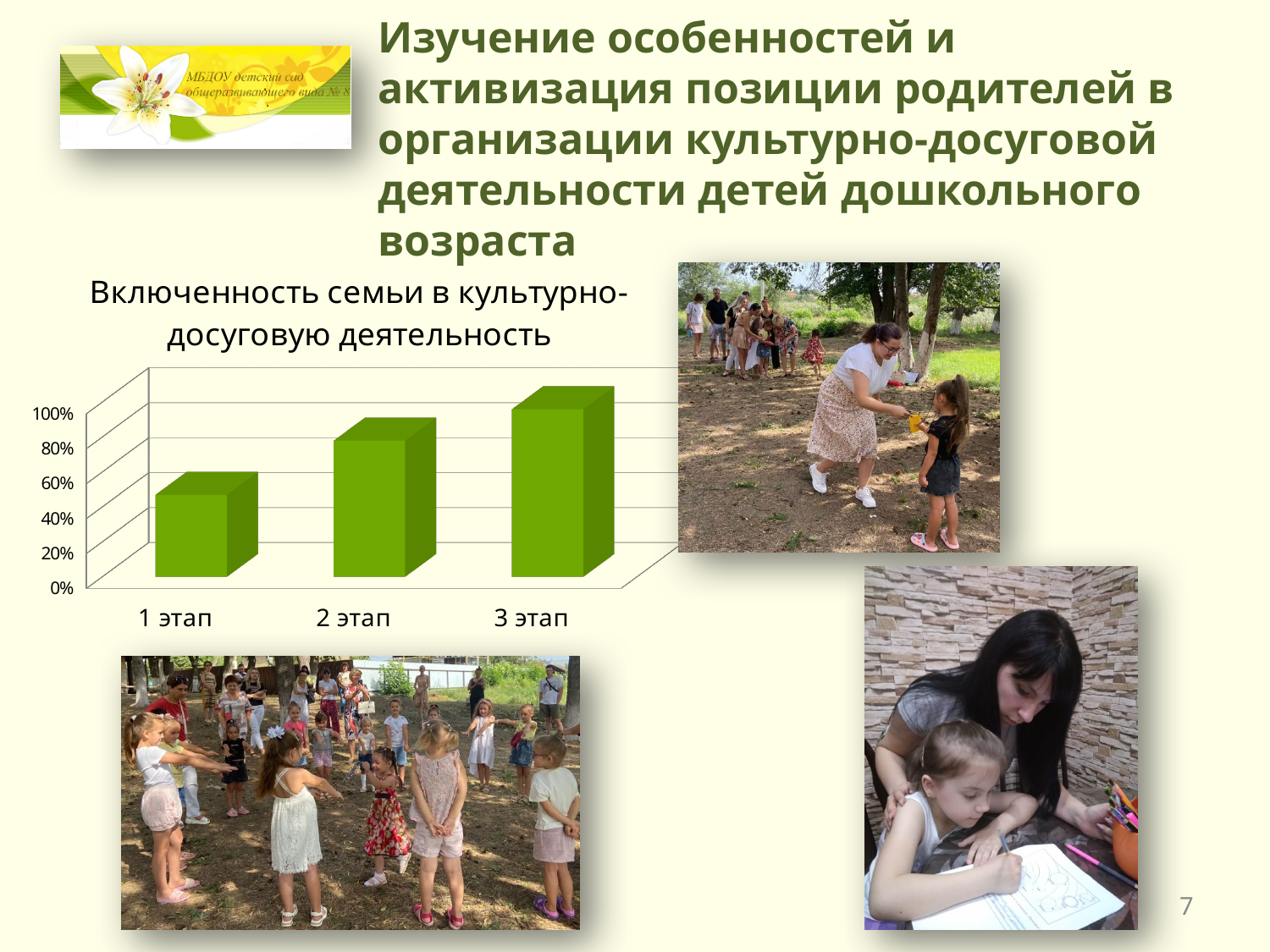
How many categories are shown on the x axis of the chart? 3 Which category has the highest value in the chart? 3 этап Is the value for 2 этап greater or less than 60%? greater Is the value for 3 этап greater or less than 80%? greater Which is larger, the value for 1 этап or the value for 2 этап? 2 этап Is the value for 1 этап greater or less than 80%? less Which category has the lowest value in the chart? 1 этап What kind of chart is shown on the slide? bar chart Which is larger, the value for 2 этап or the value for 3 этап? 3 этап What is the title of the chart on the slide? Включенность семьи в культурно-досуговую деятельность Do the values rise or fall from 1 этап to 3 этап? rise